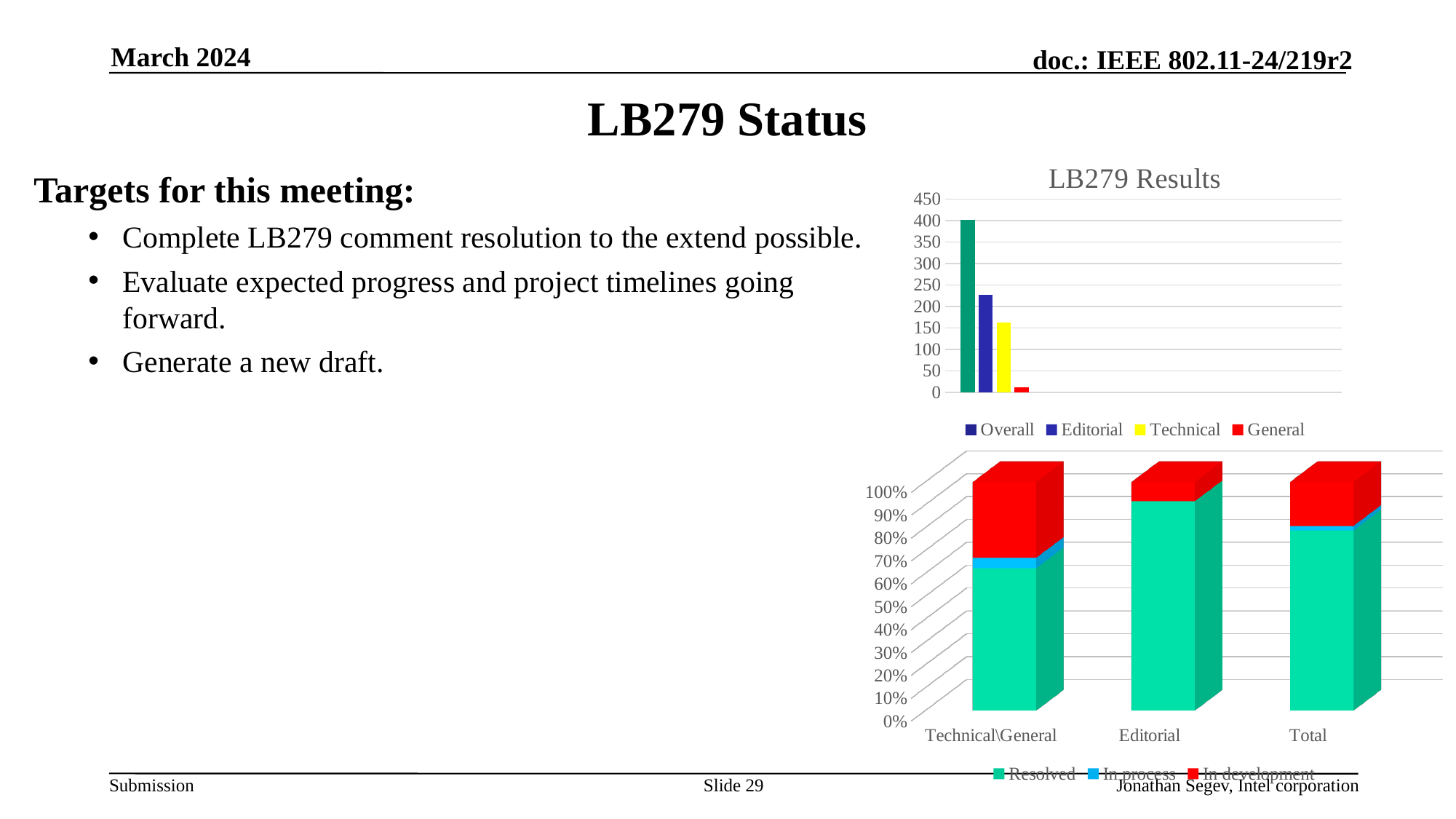
In the LB279 Results chart, which is larger, Editorial or Technical? Editorial In the LB279 Results chart, is the value for Technical greater or less than 200? less In the LB279 Results chart, which series has the highest value? Overall How many series does the legend of the LB279 Results chart list? 4 In the lower stacked bar chart, is the Resolved share for Total greater or less than 70%? greater In the LB279 Results chart, which series has the lowest value? General What kind of chart is the lower chart on the slide? Stacked bar chart How many categories are shown on the x axis of the lower stacked bar chart? 3 In the lower stacked bar chart, which category has the larger Resolved share, Editorial or Technical\General? Editorial In the LB279 Results chart, is the value for Overall greater or less than 350? greater